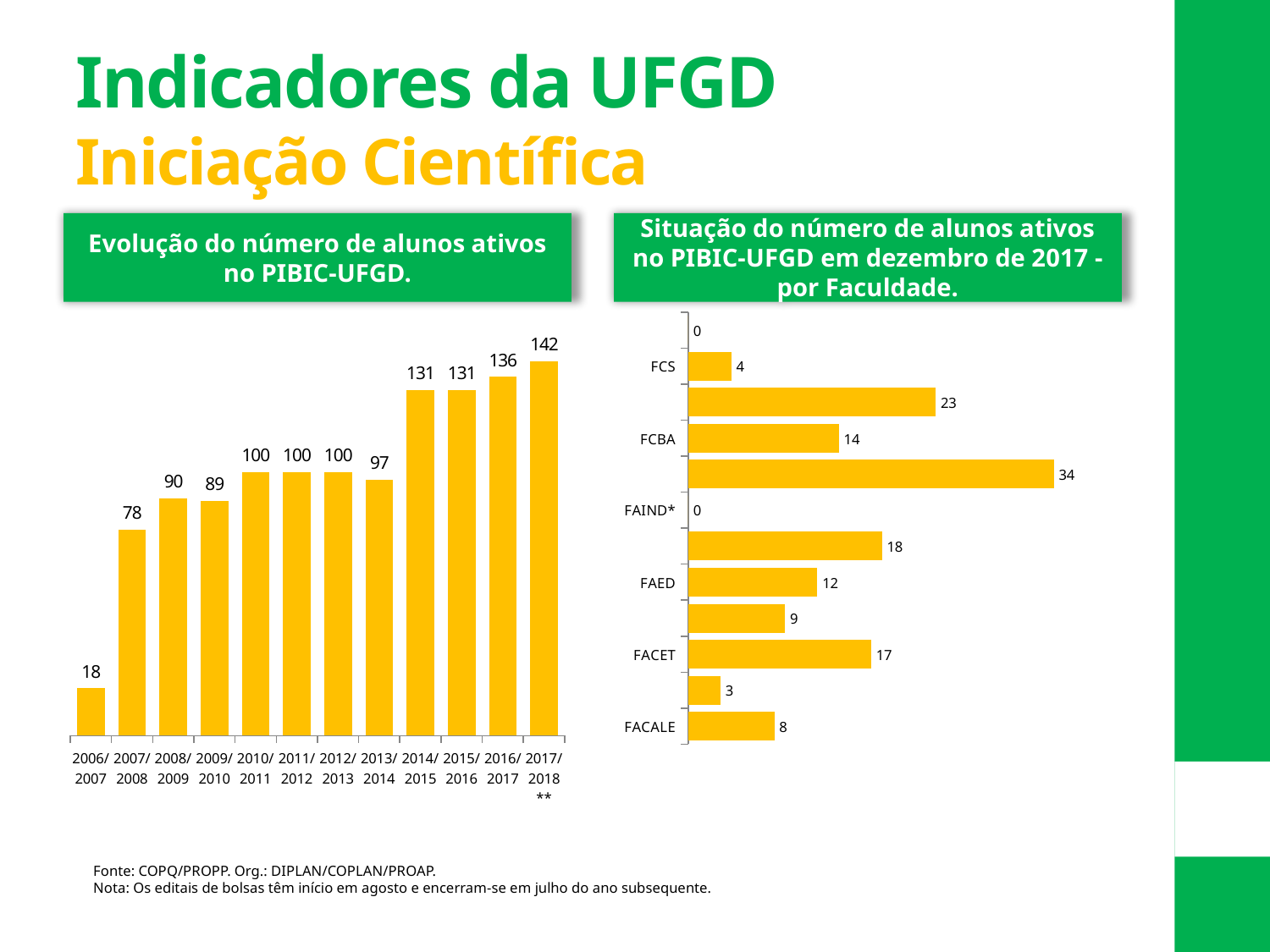
What kind of chart is 'Situação do número de alunos ativos no PIBIC-UFGD em dezembro de 2017 - por Faculdade'? bar chart In the chart 'Evolução do número de alunos ativos no PIBIC-UFGD', which period has the lowest value? 2006/2007 In the chart 'Situação do número de alunos ativos no PIBIC-UFGD em dezembro de 2017 - por Faculdade', what is the value for FACET? 17 In the chart 'Evolução do número de alunos ativos no PIBIC-UFGD', which period has the highest value? 2017/2018** In the chart 'Evolução do número de alunos ativos no PIBIC-UFGD', which is larger, the value for 2008/2009 or 2009/2010? 2008/2009 In the chart 'Situação do número de alunos ativos no PIBIC-UFGD em dezembro de 2017 - por Faculdade', which is larger, the value for FCBA or FAED? FCBA In the chart 'Evolução do número de alunos ativos no PIBIC-UFGD', how many periods are shown on the x axis? 12 In the chart 'Evolução do número de alunos ativos no PIBIC-UFGD', what is the difference between the values for 2017/2018** and 2016/2017? 6 In the chart 'Evolução do número de alunos ativos no PIBIC-UFGD', what is the value for 2006/2007? 18 In the chart 'Situação do número de alunos ativos no PIBIC-UFGD em dezembro de 2017 - por Faculdade', what is the value for FAIND*? 0 In the chart 'Evolução do número de alunos ativos no PIBIC-UFGD', what is the value for 2013/2014? 97 In the chart 'Evolução do número de alunos ativos no PIBIC-UFGD', do the values generally rise or fall from 2006/2007 to 2017/2018**? rise